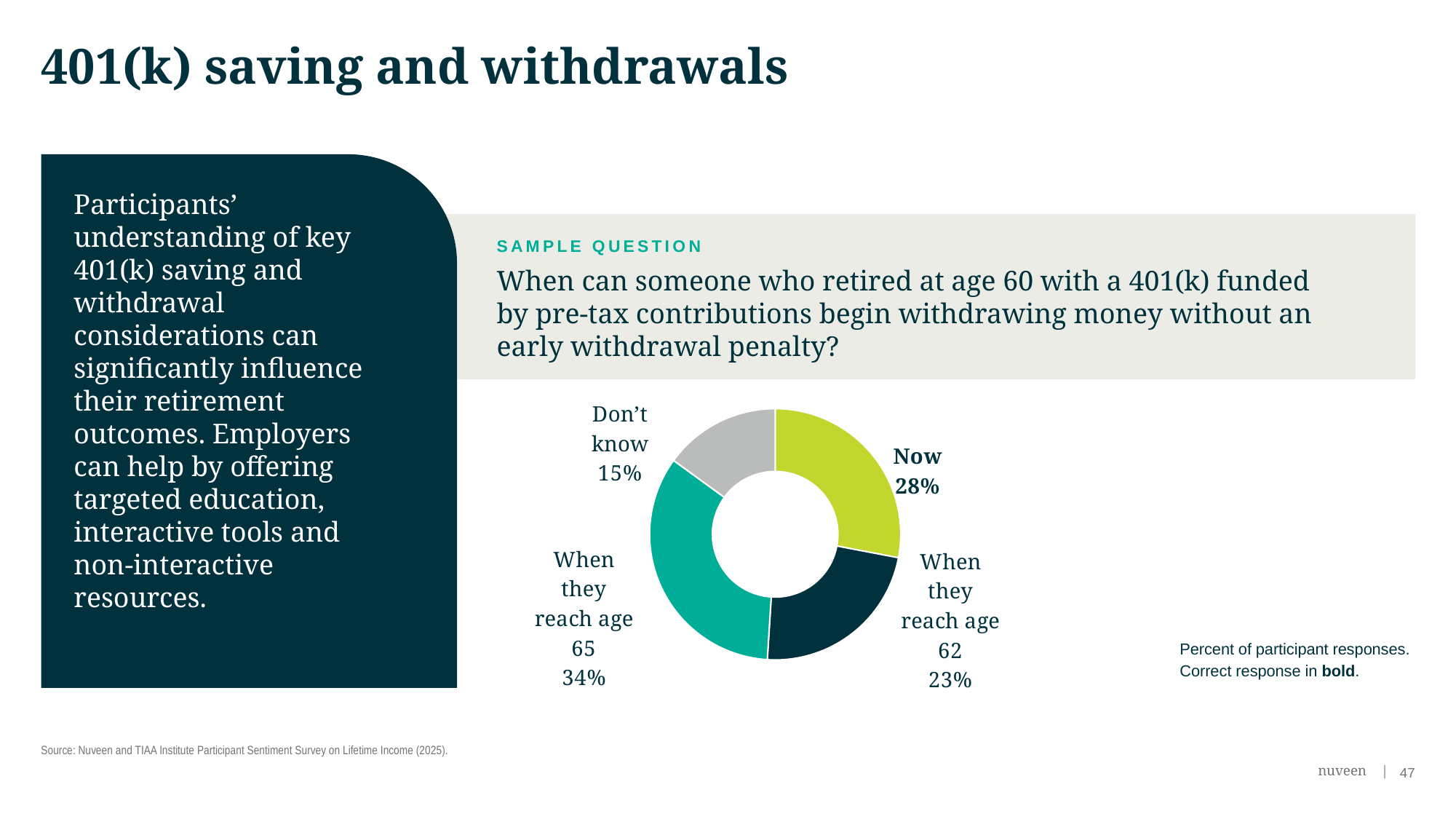
What is the combined share of "Now" and "Don't know"? 43% How many response categories are shown in the chart? 4 What percentage of participants answered "When they reach age 62"? 23% Which response has a larger share: "Now" or "When they reach age 62"? Now What percentage of participants answered "Don't know"? 15% What is the difference in percentage points between "When they reach age 65" and "Now"? 6 Which response received the smallest share of participants? Don't know What kind of chart is shown on the slide? Donut (pie) chart What percentage of participants answered "Now"? 28% Which response received the largest share of participants? When they reach age 65 Which response is shown in bold as the correct answer? Now What percentage of participants answered "When they reach age 65"? 34%